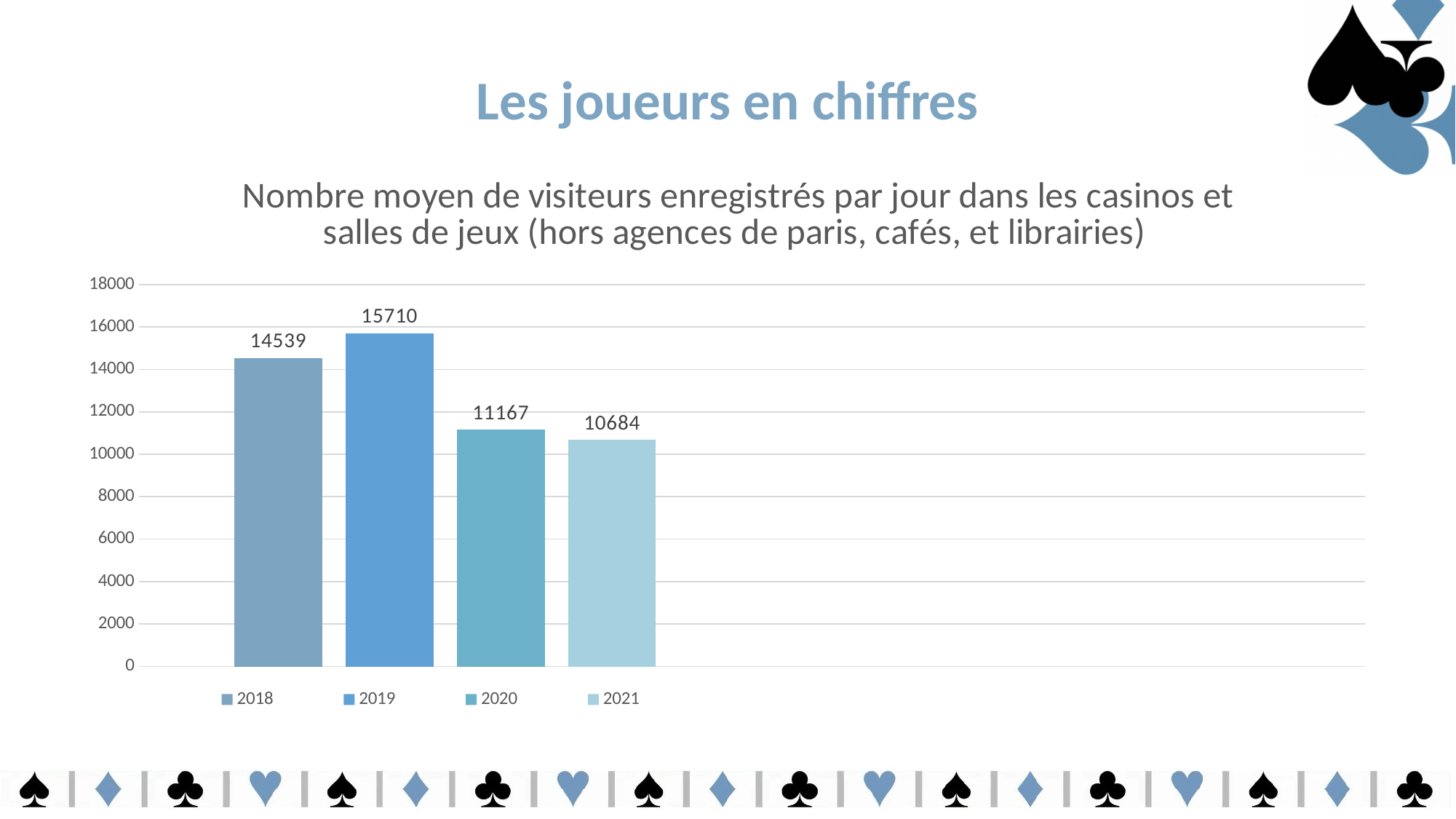
What is the value shown for 2021? 10684 What is the difference between the values for 2018 and 2021? 3855 Do the values rise or fall from 2019 to 2021? fall Which year has the lowest average number of visitors per day? 2021 How many bars are plotted in the chart? 4 What is the difference between the values for 2019 and 2020? 4543 Which is larger, the value for 2018 or the value for 2020? 2018 Which year has the highest average number of visitors per day? 2019 What kind of chart is shown on the slide? bar chart Is the value for 2020 greater or less than 12000? less What is the average number of daily visitors recorded for 2018? 14539 How many entries does the legend list? 4